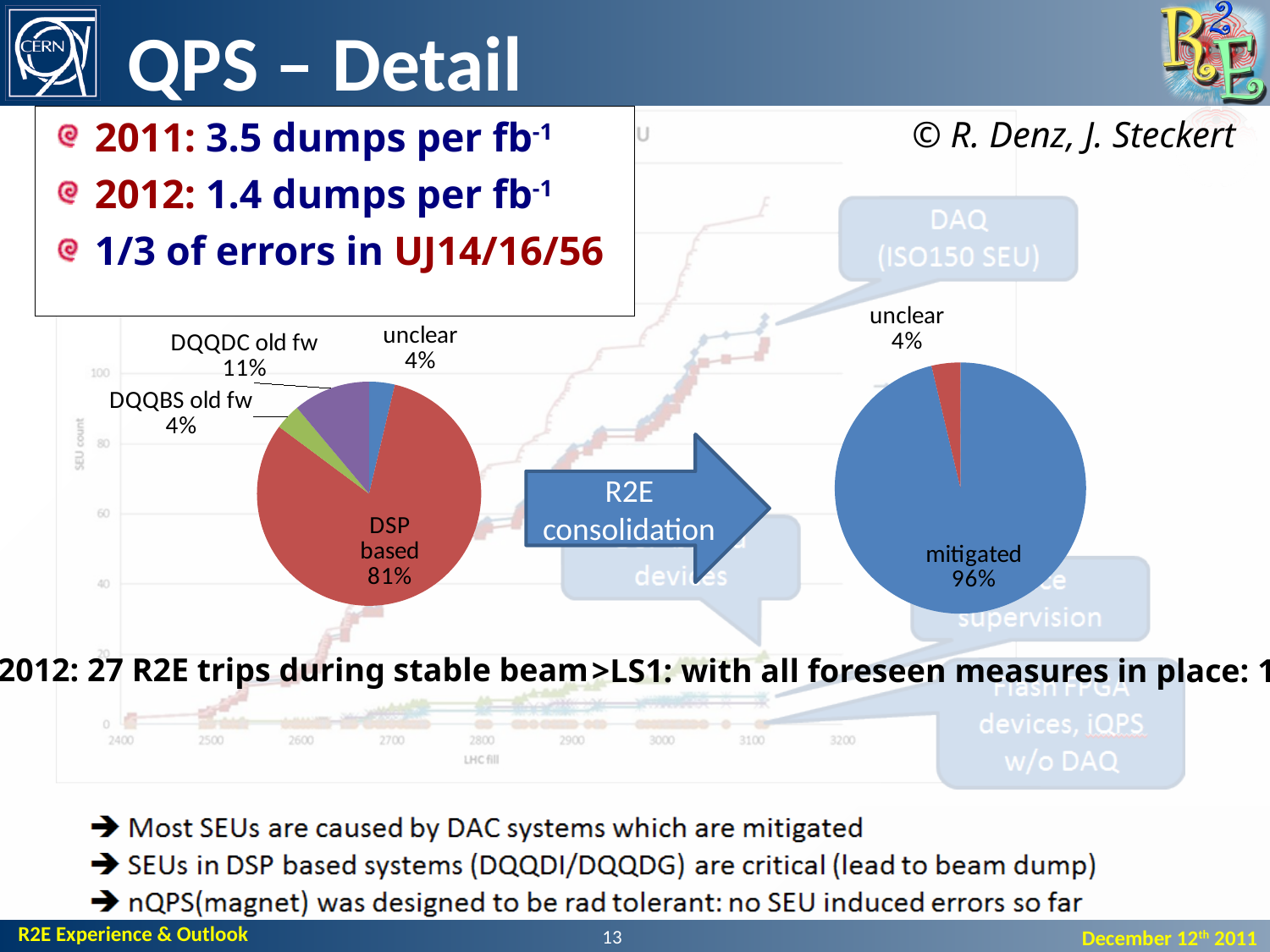
In the left pie chart, what share is labelled 'DSP based'? 81% In the right pie chart, which slice is the smallest? unclear In the right pie chart, what share is labelled 'unclear'? 4% In the right pie chart, how many slices are there? 2 In the right pie chart, what share is labelled 'mitigated'? 96% In the left pie chart, what share is labelled 'unclear'? 4% In the left pie chart, what share is labelled 'DQQBS old fw'? 4% In the left pie chart, what share is labelled 'DQQDC old fw'? 11% In the left pie chart, which slice is the largest? DSP based What kind of chart is the chart on the right labelled 'mitigated 96%'? pie chart In the left pie chart, what is the difference between the 'DSP based' share and the 'DQQDC old fw' share? 70% In the left pie chart, how many slices are there? 4